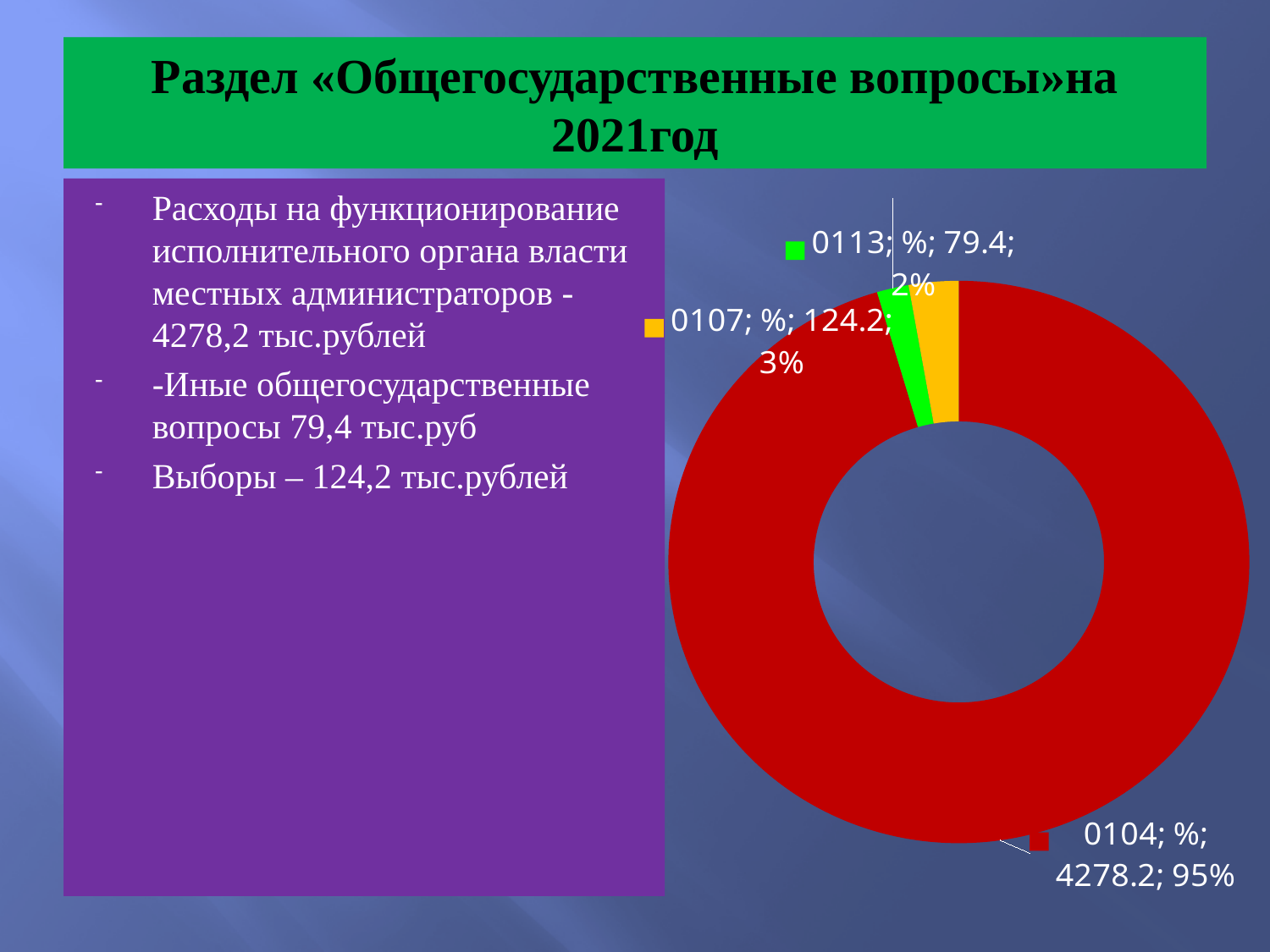
What percentage share of the chart does category 0113 have? 2% Which category has the largest slice in the chart? 0104 What is the difference between the values for 0107 and 0113? 44.8 What type of chart is shown on the slide? Doughnut (pie) chart Which is larger, the value for 0107 or the value for 0113? 0107 What value is shown for category 0104 in the chart? 4278.2 How many categories are shown in the chart? 3 What value is shown for category 0113 in the chart? 79.4 What percentage share of the chart does category 0104 have? 95% What percentage share of the chart does category 0107 have? 3% What value is shown for category 0107 in the chart? 124.2 Which category has the smallest slice in the chart? 0113